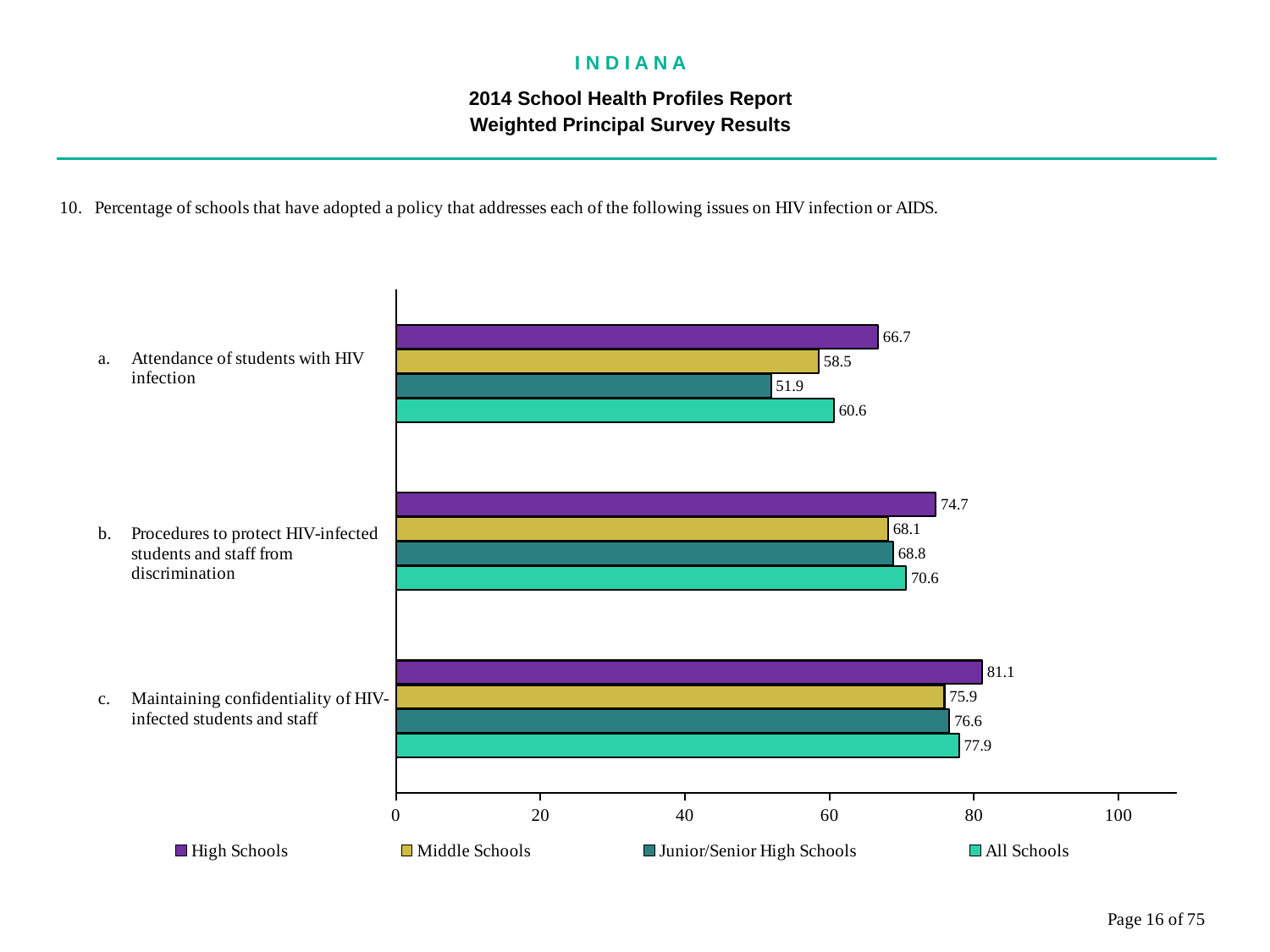
What is the value for High Schools for 'Attendance of students with HIV infection'? 66.7 How many series does the legend list? 4 What is the value for Middle Schools for 'Maintaining confidentiality of HIV-infected students and staff'? 75.9 Is the value for Junior/Senior High Schools for 'Attendance of students with HIV infection' greater or less than 60? less What is the difference between the High Schools and Middle Schools values for 'Attendance of students with HIV infection'? 8.2 How many categories (issues) are shown on the chart? 3 Which school type has the lowest value for 'Attendance of students with HIV infection'? Junior/Senior High Schools Which is larger for 'Procedures to protect HIV-infected students and staff from discrimination': High Schools or All Schools? High Schools What kind of chart is shown on the slide? Bar chart What is the value for Junior/Senior High Schools for 'Procedures to protect HIV-infected students and staff from discrimination'? 68.8 What is the value for All Schools for 'Maintaining confidentiality of HIV-infected students and staff'? 77.9 Which category has the highest value for High Schools? Maintaining confidentiality of HIV-infected students and staff